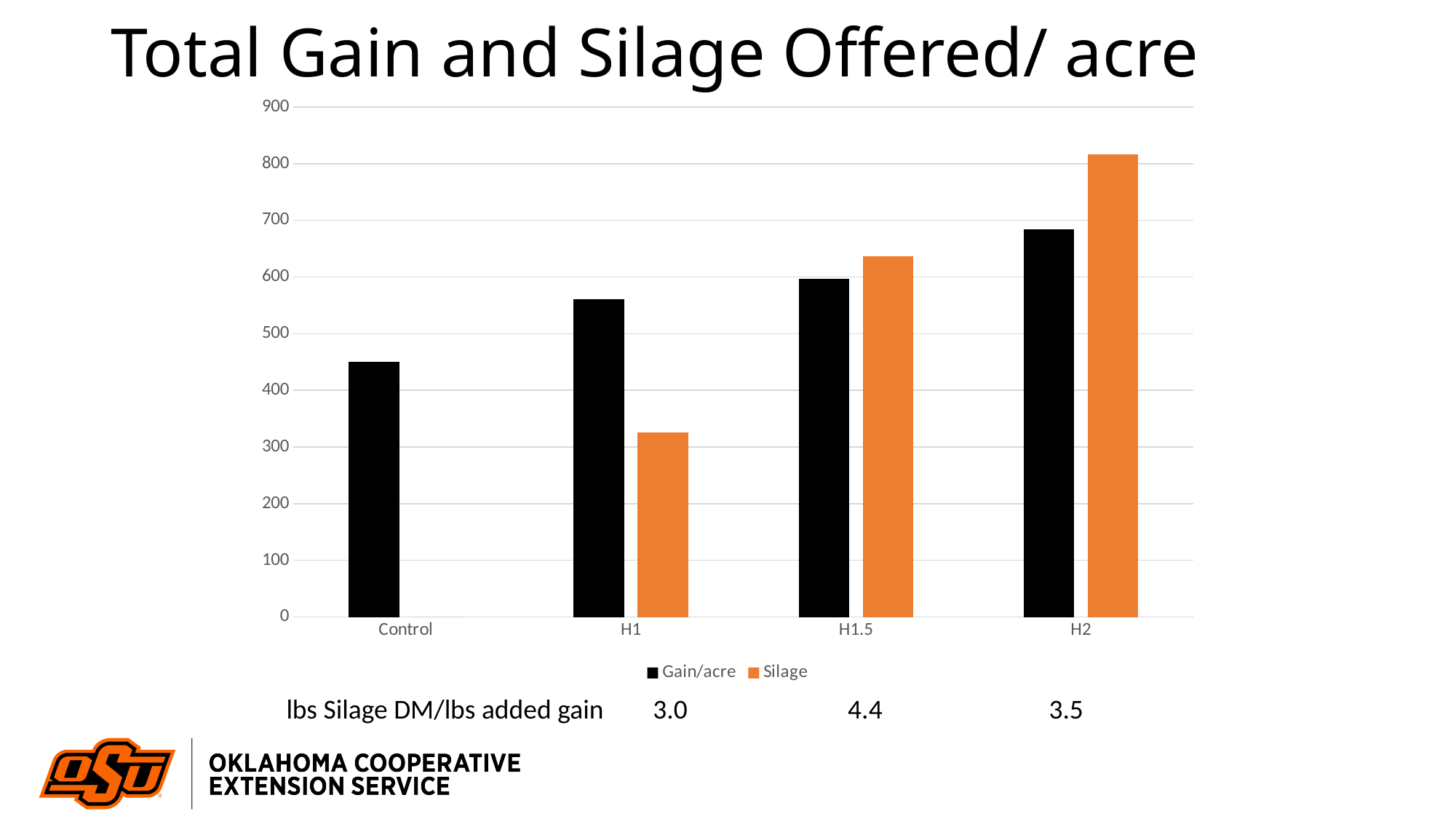
Do the Gain/acre values rise or fall from Control to H2? rise Is the Gain/acre value for Control greater or less than 400? greater For H1, which is larger, Gain/acre or Silage? Gain/acre What is the title of the chart? Total Gain and Silage Offered/ acre Is the Silage value for H2 greater or less than 800? greater Which category has the lowest Gain/acre value? Control Which category has the highest Gain/acre value? H2 Which category has the highest Silage value? H2 Is the Silage value for H1 greater or less than 400? less What kind of chart is shown on the slide? bar chart How many categories are shown on the x axis? 4 How many series does the legend list? 2